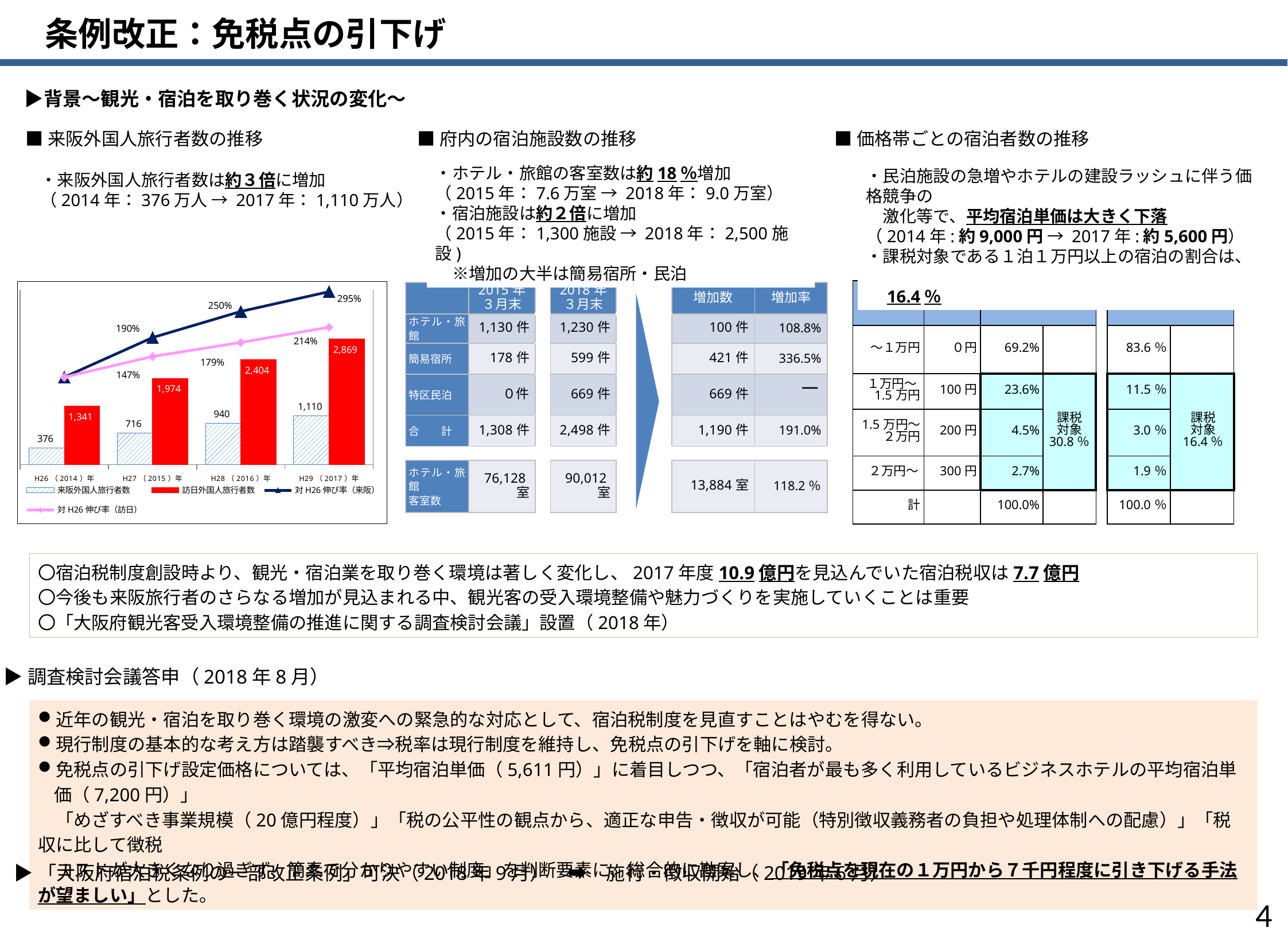
In the left chart, what is the value of 訪日外国人旅行者数 for H29（2017）年? 2,869 In the left chart, do the 来阪外国人旅行者数 values rise or fall from H26 to H29? Rise In the left chart, which year has the highest value for 訪日外国人旅行者数? H29（2017）年 In the left chart, which year has the lowest value for 来阪外国人旅行者数? H26（2014）年 How many series does the legend of the left chart list? 4 In the left chart, what is the 対H26伸び率（訪日） value for H27（2015）年? 147% In the left chart, what is the value of 来阪外国人旅行者数 for H28（2016）年? 940 In the left chart, what is the value of 来阪外国人旅行者数 for H26（2014）年? 376 In the left chart, what is the 対H26伸び率（来阪） value for H29（2017）年? 295% What kind of chart is shown on the left of the slide (the one with H26–H29 on the x axis)? Combined bar and line chart In the left chart, what is the difference between the 訪日外国人旅行者数 values for H29（2017）年 and H26（2014）年? 1,528 In the left chart, which is larger for H28（2016）年: 来阪外国人旅行者数 or 訪日外国人旅行者数? 訪日外国人旅行者数